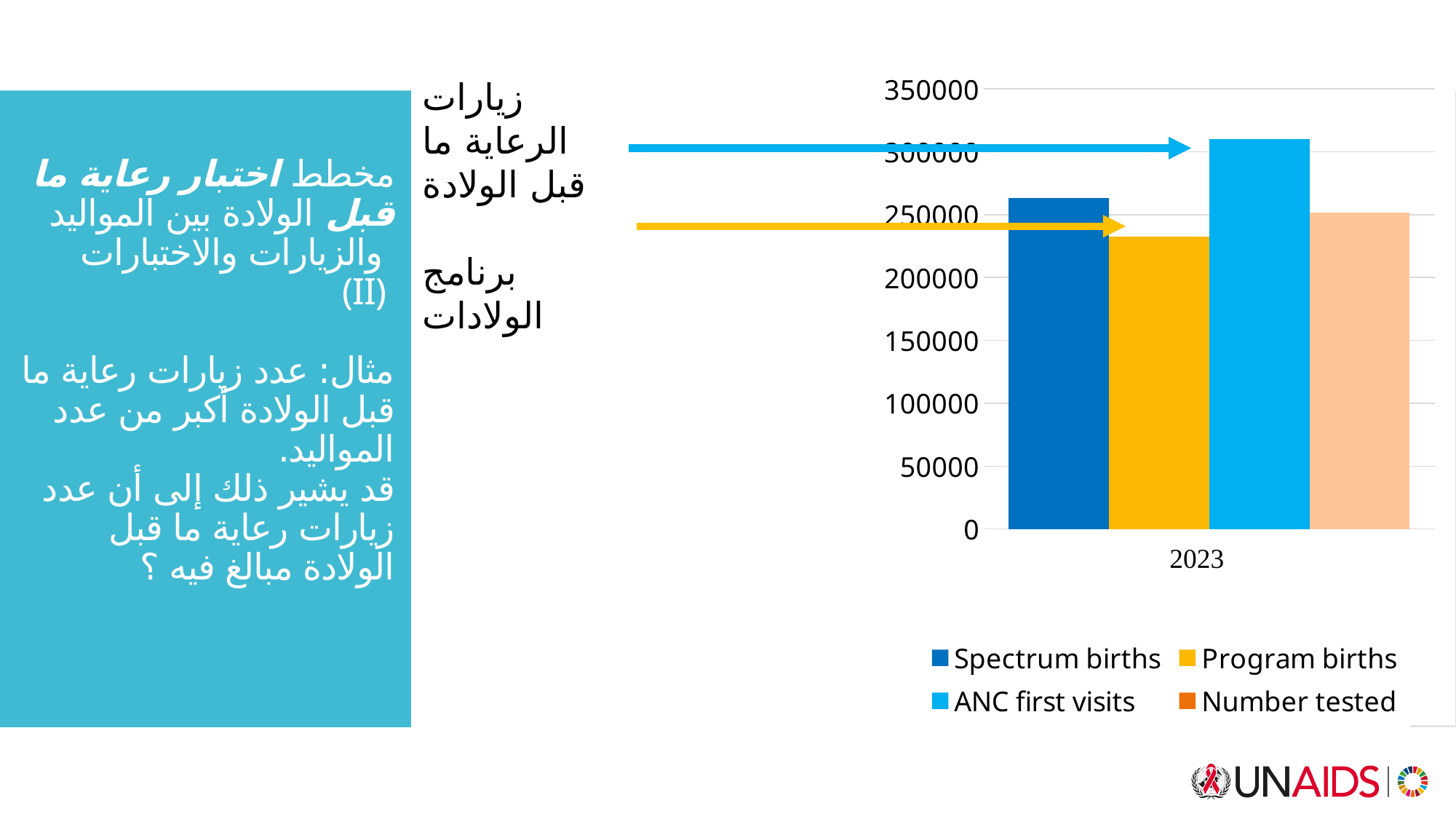
How many series does the chart legend list? 4 Is the value for Spectrum births greater or less than 250000? greater Which is larger, Spectrum births or Program births? Spectrum births Is the value for Number tested greater or less than 300000? less What year is shown on the x axis of the chart? 2023 Which is larger, ANC first visits or Number tested? ANC first visits Which series has the lowest value in the chart? Program births Is the value for Program births greater or less than 250000? less Which series has the highest value in the chart? ANC first visits What kind of chart is shown on the slide? bar chart How many categories are shown on the x axis of the chart? 1